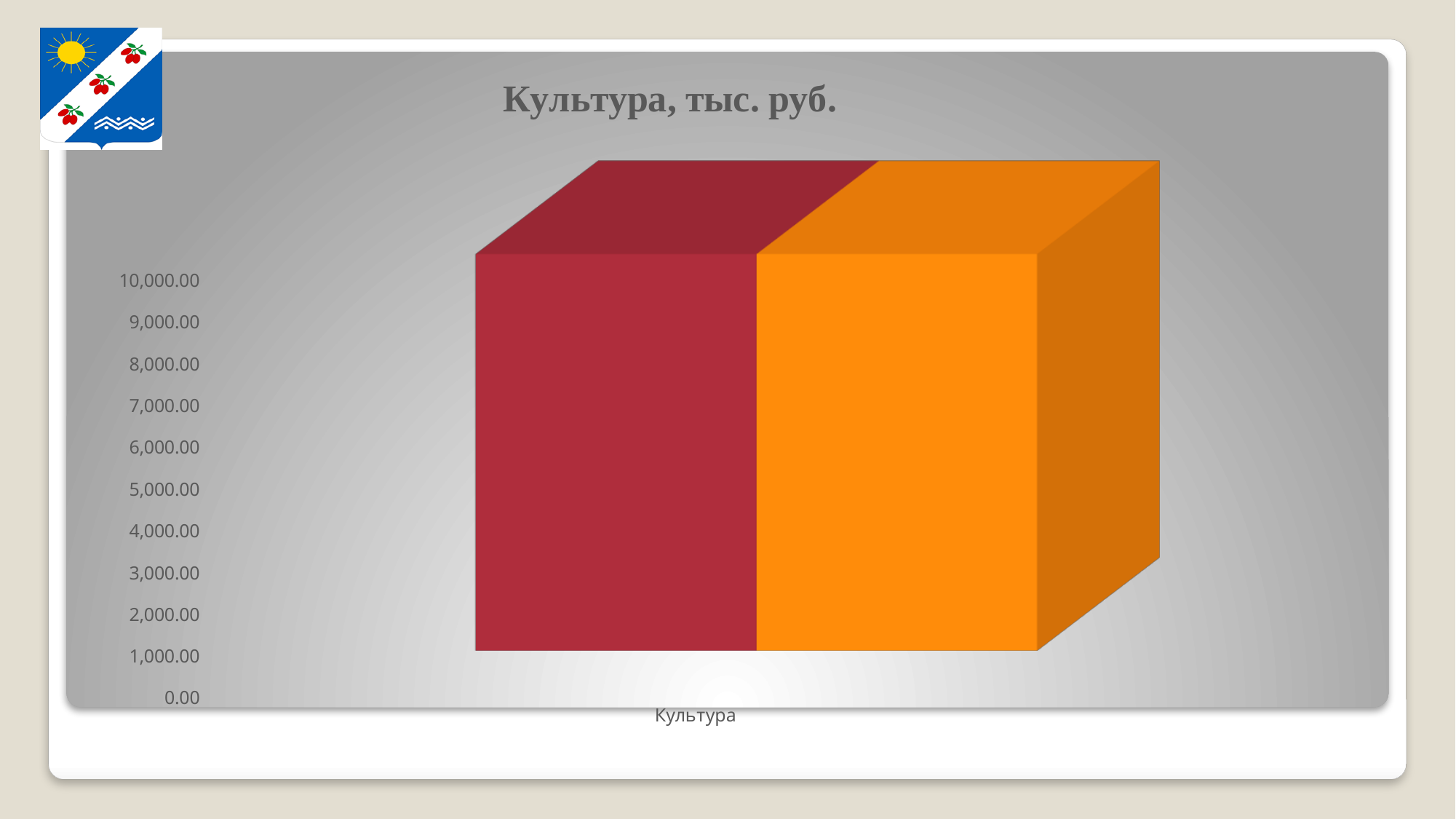
How many bars are plotted for the category Культура? 2 What is the category label on the x axis of the chart? Культура What is the highest tick value shown on the vertical axis of the chart? 10,000.00 How many categories are shown on the x axis of the chart? 1 Is the value of the red bar for Культура greater or less than 5,000.00? greater What is the title of the chart? Культура, тыс. руб. What kind of chart is shown on the slide? bar chart Is the value of the red bar for Культура greater or less than 9,000.00? greater Is the value of the orange bar for Культура greater or less than 8,000.00? greater